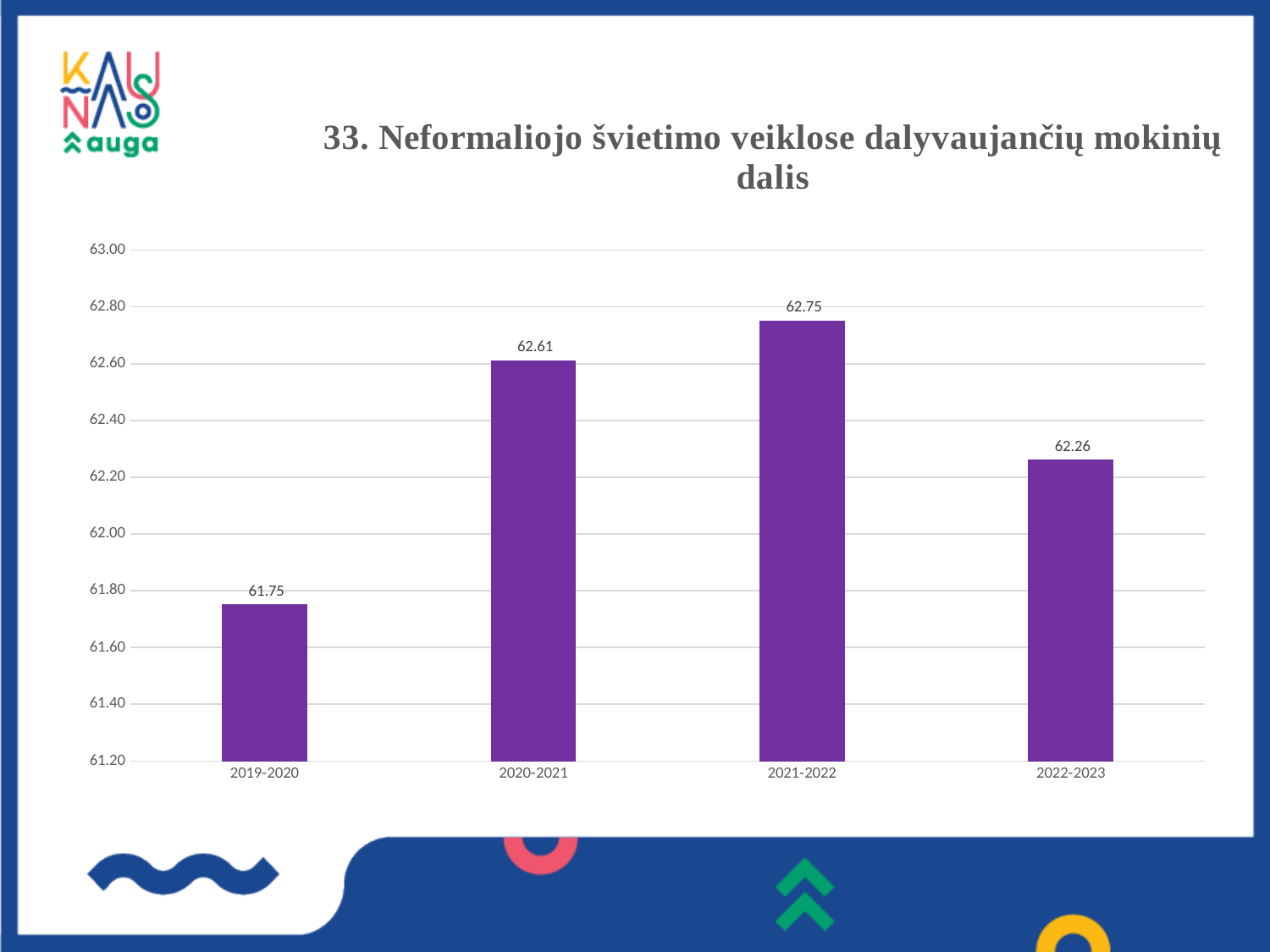
What kind of chart is shown on the slide? bar chart How many periods are shown on the x axis? 4 What is the difference between the values for 2021-2022 and 2019-2020? 1.00 What is the value for 2019-2020? 61.75 Which is larger, the value for 2020-2021 or the value for 2022-2023? 2020-2021 Which period has the highest value? 2021-2022 What is the value for 2022-2023? 62.26 What is the value for 2021-2022? 62.75 Which period has the lowest value? 2019-2020 Is the value for 2022-2023 greater or less than 62.00? greater What is the difference between the values for 2020-2021 and 2022-2023? 0.35 What is the title of the chart? 33. Neformaliojo švietimo veiklose dalyvaujančių mokinių dalis